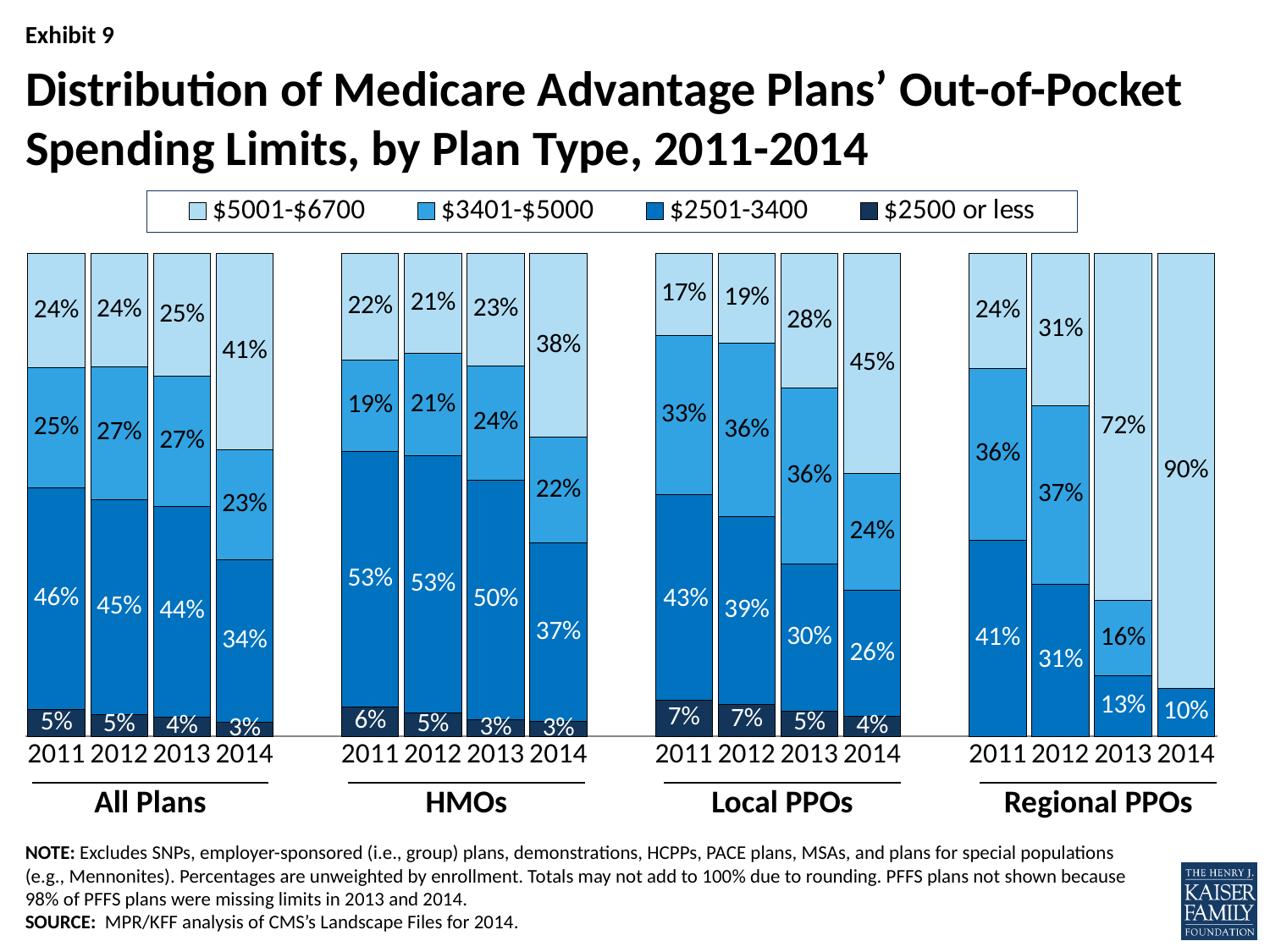
For All Plans in 2014, what percentage of plans had an out-of-pocket limit of $5001-$6700? 41% For Regional PPOs in 2014, what percentage of plans had a limit of $5001-$6700? 90% Among the Local PPOs bars, which year has the highest share of plans with a $5001-$6700 limit? 2014 For All Plans, does the $5001-$6700 share rise or fall from 2011 to 2014? Rise How many spending-limit categories does the legend list? 4 How many plan type groups are shown along the x axis? 4 For All Plans, how many percentage points higher is the $2501-3400 share in 2011 than in 2014? 12 percentage points For HMOs in 2011, what percentage of plans had a limit of $2501-3400? 53% Among the All Plans bars, which year has the lowest share of plans with a limit of $2500 or less? 2014 In 2013, which has the larger $3401-$5000 share: HMOs or Local PPOs? Local PPOs For Local PPOs in 2012, what percentage of plans had a limit of $2500 or less? 7% What kind of chart is shown on the slide? Stacked bar chart